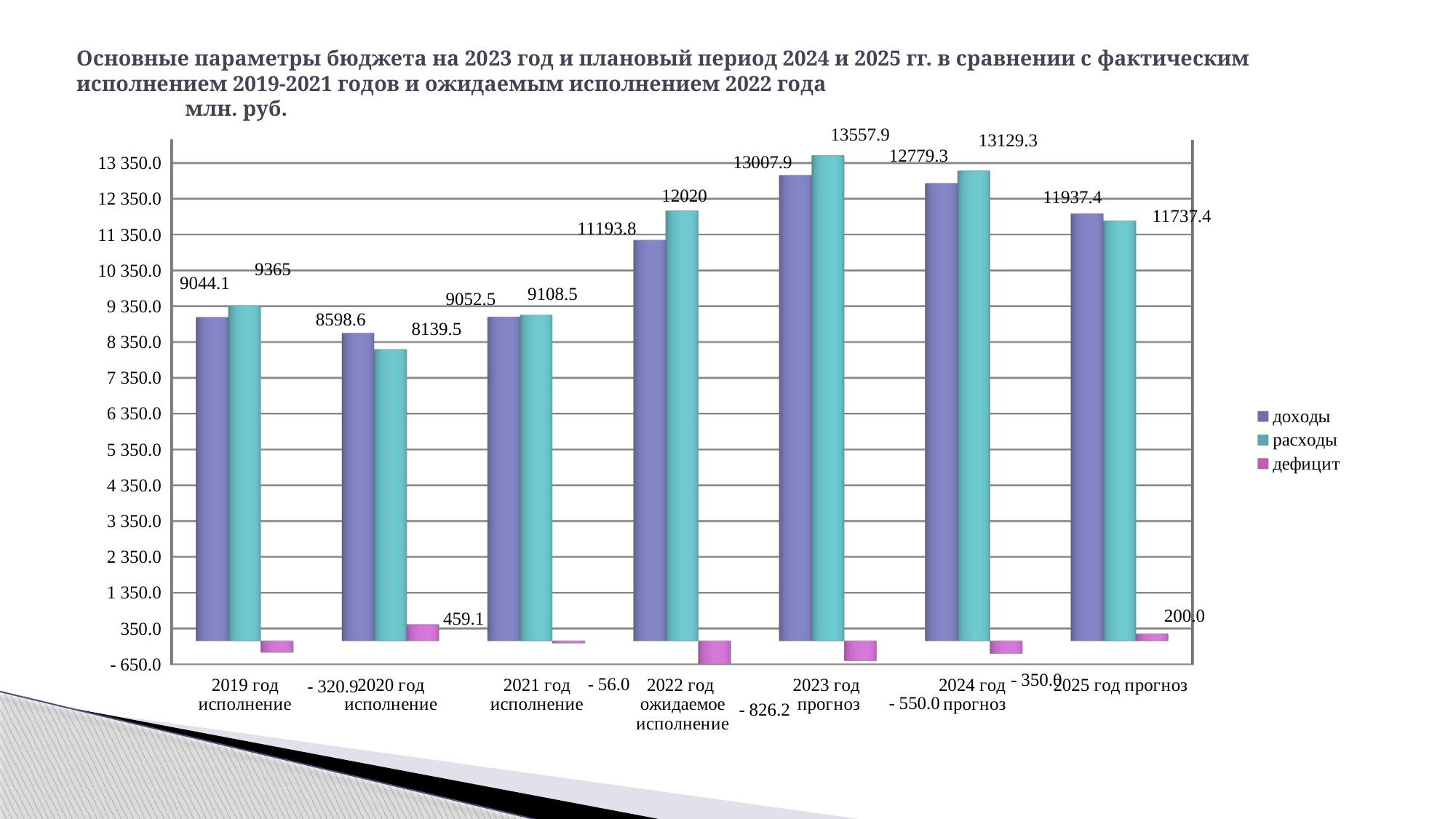
By how much do расходы exceed доходы in 2023 год прогноз? 550.0 What is the value of расходы for 2022 год ожидаемое исполнение? 12020 What type of chart is shown on the slide? bar chart What unit of measurement is stated above the chart? млн. руб. Which year has the highest value of расходы? 2023 год прогноз What is the value of дефицит for 2020 год исполнение? 459.1 In 2025 год прогноз, which is larger: доходы or расходы? доходы How many year categories are shown on the x axis? 7 Which year has the lowest value of доходы? 2020 год исполнение What is the value of доходы for 2023 год прогноз? 13007.9 Do the values of доходы rise or fall from 2023 год прогноз to 2025 год прогноз? fall How many series does the legend list? 3